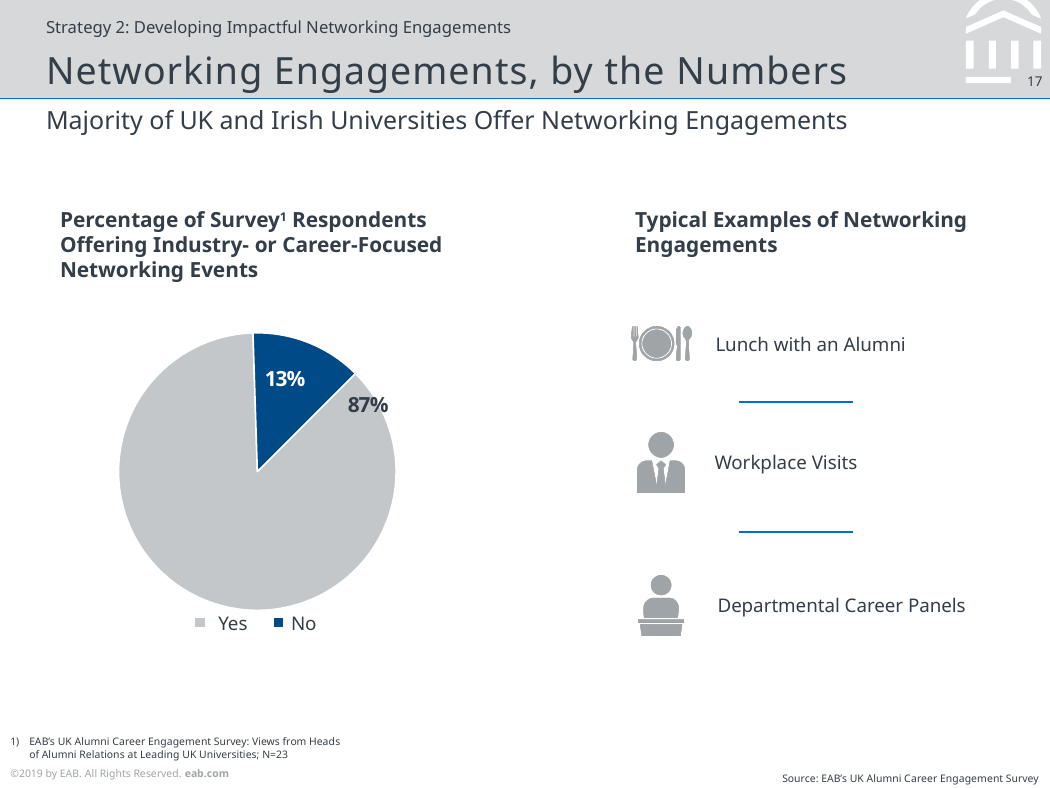
What percentage of survey respondents answered "No"? 13% How many categories does the pie chart show? 2 What type of chart is shown on the slide? Pie chart Which category has the largest share of the pie? Yes What is the difference in percentage points between the "Yes" and "No" slices? 74 What share of the pie does the "No" slice represent? 13% Which is larger, the "Yes" slice or the "No" slice? Yes What colour is the "No" slice in the pie chart? Blue What percentage of survey respondents answered "Yes" to offering industry- or career-focused networking events? 87% What is the title of the pie chart? Percentage of Survey Respondents Offering Industry- or Career-Focused Networking Events How many entries does the legend list? 2 Which category has the smallest share of the pie? No